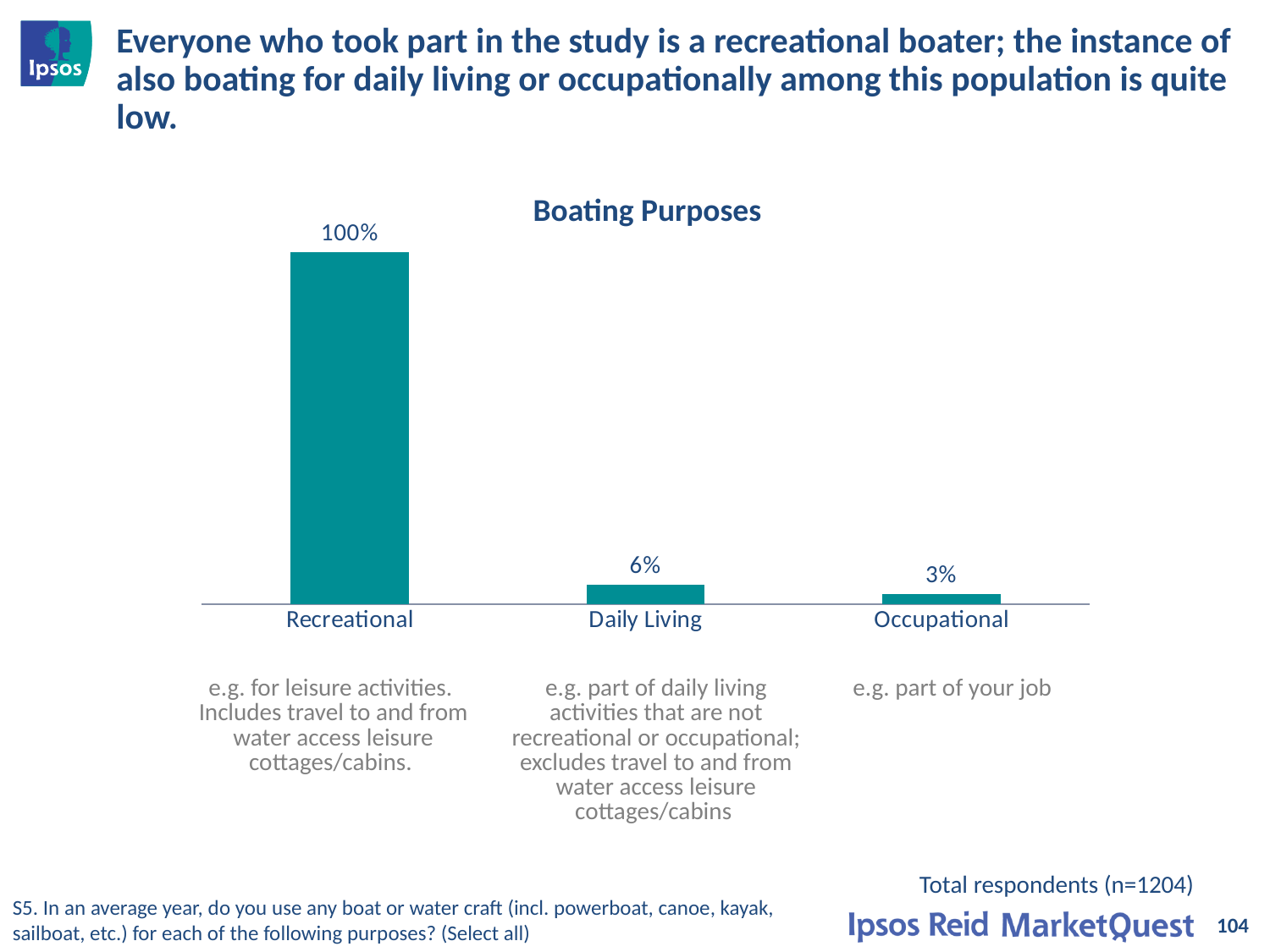
What is the title of the chart? Boating Purposes Do the values rise or fall from left to right across the categories? Fall What is the value for Daily Living in the Boating Purposes chart? 6% How many boating purposes are shown in the chart? 3 What is the difference between the values for Daily Living and Occupational? 3% What is the value for Recreational in the Boating Purposes chart? 100% What is the value for Occupational in the Boating Purposes chart? 3% Which boating purpose has the lowest value? Occupational What kind of chart is shown on the slide? Bar chart Which boating purpose has the highest value? Recreational What is the difference between the values for Recreational and Daily Living? 94% Which is larger, the value for Daily Living or the value for Occupational? Daily Living